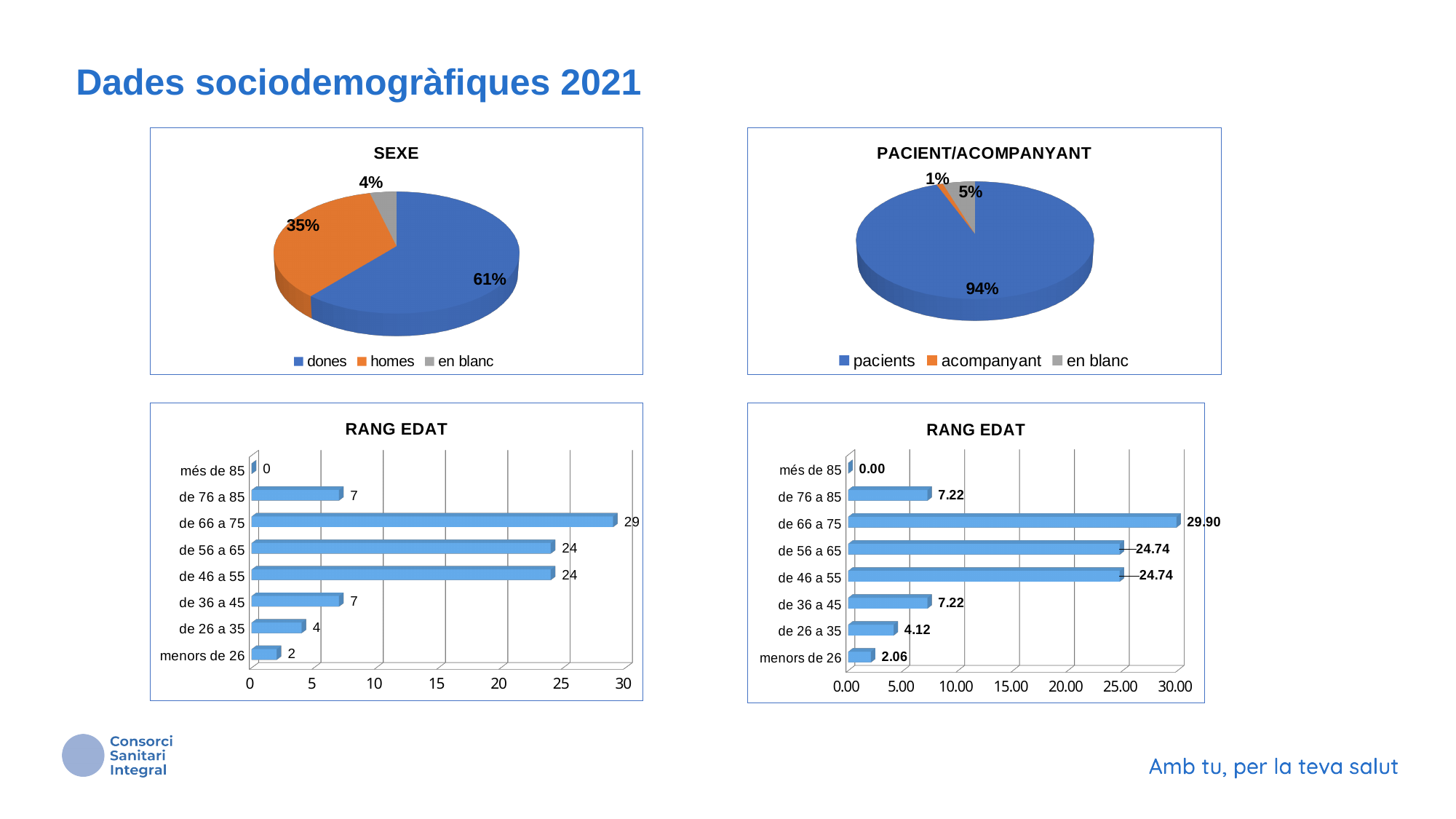
In the PACIENT/ACOMPANYANT pie chart, what share is labelled for en blanc? 5% In the bottom-left RANG EDAT chart, what is the difference between de 66 a 75 and de 56 a 65? 5 In the bottom-right RANG EDAT chart, what is the value for de 76 a 85? 7.22 In the bottom-right RANG EDAT chart, which is larger, de 26 a 35 or menors de 26? de 26 a 35 In the bottom-left RANG EDAT chart, what is the value for de 66 a 75? 29 In the SEXE pie chart, what share is labelled for homes? 35% What kind of chart is the bottom-right RANG EDAT chart? bar chart How many entries does the legend of the SEXE pie chart list? 3 In the bottom-left RANG EDAT chart, which age range has the highest value? de 66 a 75 In the SEXE pie chart, what share is labelled for dones? 61% How many age ranges are shown in the bottom-left RANG EDAT chart? 8